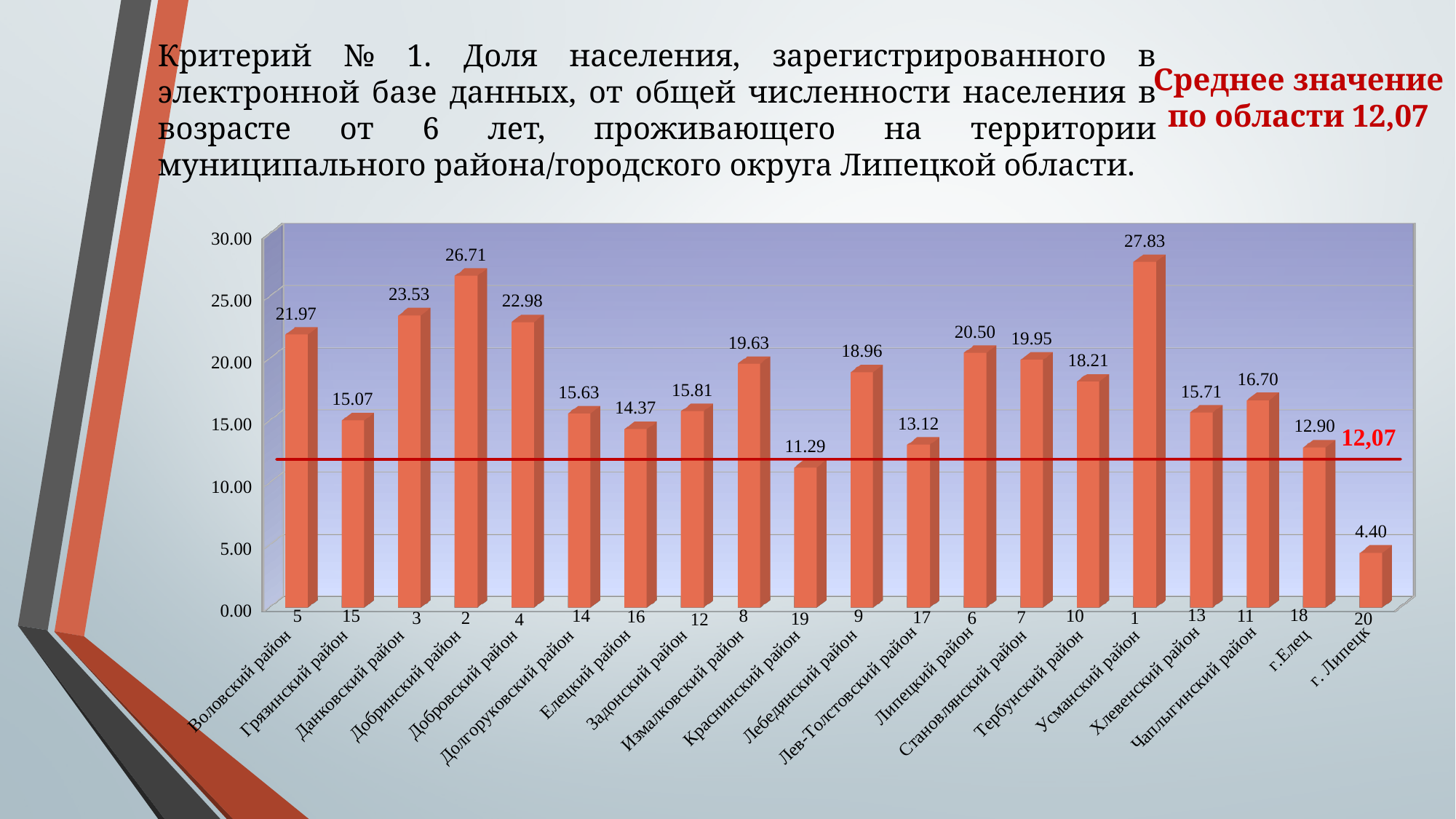
What is the value for Краснинский район? 11.29 What is the value for г. Липецк? 4.40 Is the value for Лев-Толстовский район greater or less than 15.00? less Which is larger, the value for Данковский район or the value for Добровский район? Данковский район What is the value for Чаплыгинский район? 16.70 What value does the red horizontal line on the chart mark? 12,07 What is the value for Усманский район? 27.83 Which category has the highest value? Усманский район What kind of chart is shown on the slide? bar chart How many categories are shown on the x axis? 20 Which category has the lowest value? г. Липецк What is the difference between the values for Добринский район and Воловский район? 4.74